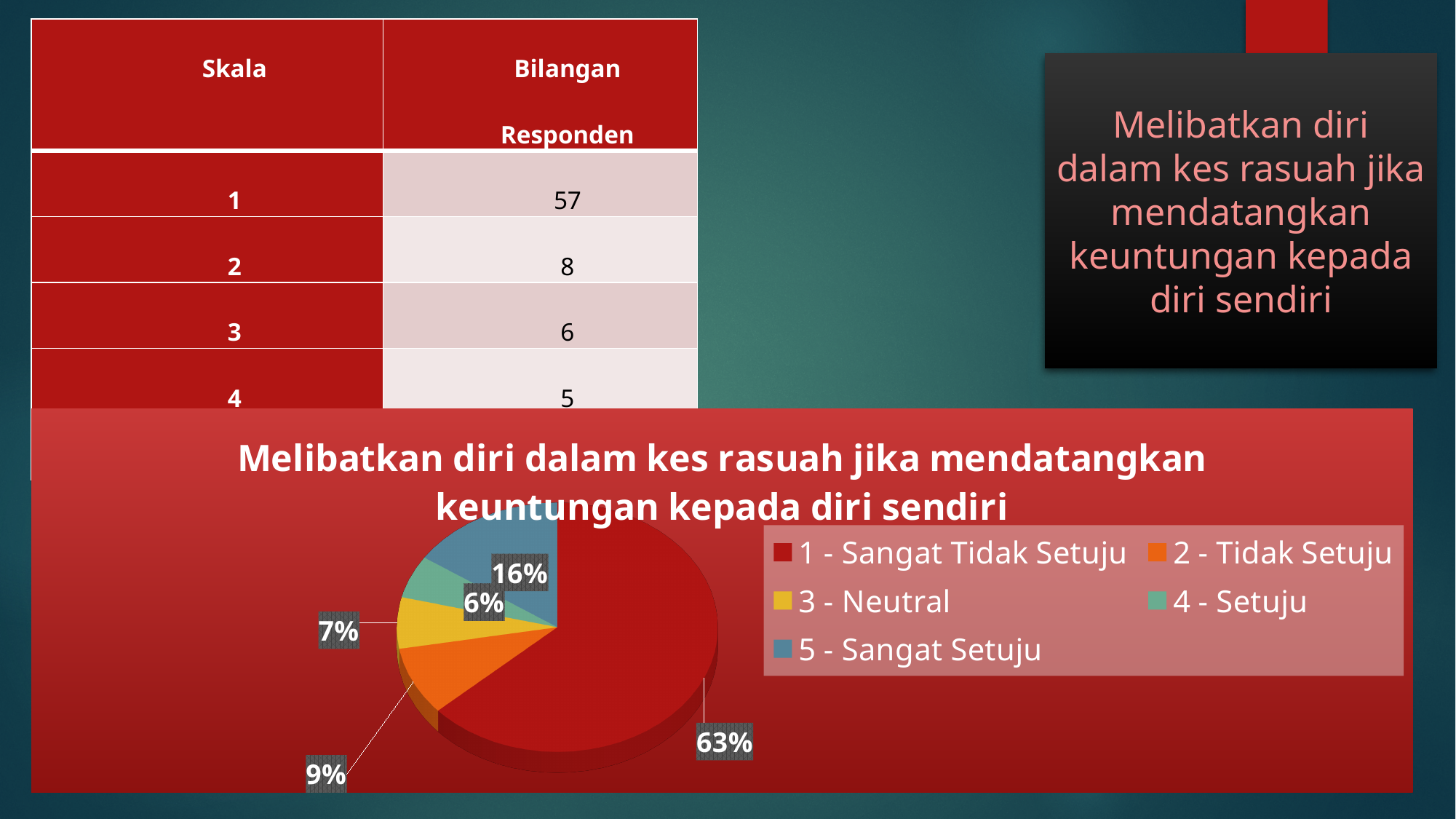
What colour is the "5 - Sangat Setuju" slice in the pie chart? blue What percentage of the pie chart is labelled for "4 - Setuju"? 6% What percentage of the pie chart is labelled for "1 - Sangat Tidak Setuju"? 63% What percentage of the pie chart is labelled for "5 - Sangat Setuju"? 16% Which category has the largest slice in the pie chart? 1 - Sangat Tidak Setuju What is the difference in percentage points between the "1 - Sangat Tidak Setuju" slice and the "5 - Sangat Setuju" slice? 47 Which category has the smallest slice in the pie chart? 4 - Setuju What percentage of the pie chart is labelled for "2 - Tidak Setuju"? 9% What percentage of the pie chart is labelled for "3 - Neutral"? 7% What type of chart is shown on the slide? pie chart How many categories does the pie chart's legend list? 5 Which slice is larger in the pie chart: "2 - Tidak Setuju" or "5 - Sangat Setuju"? 5 - Sangat Setuju